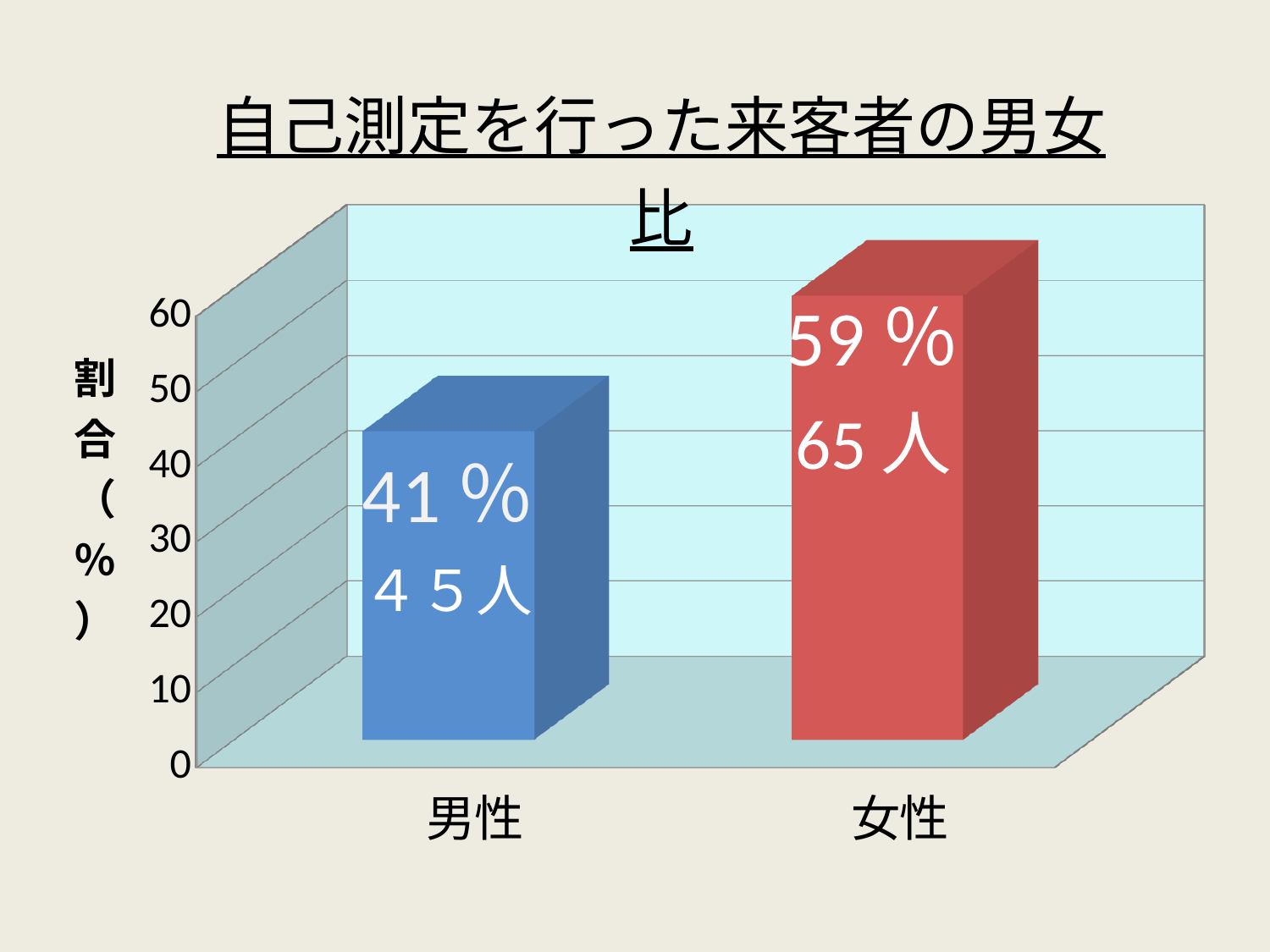
What is the title of the chart? 自己測定を行った来客者の男女比 Which category has the higher percentage? 女性 What is the difference in percentage points between 女性 and 男性? 18 How many people does the 女性 bar label show? 65人 How many people does the 男性 bar label show? ４５人 Which category has the lower percentage? 男性 Is the value for 男性 greater or less than 50? less What percentage is shown for 男性? 41％ How many more people are in the 女性 group than the 男性 group? 20人 What percentage is shown for 女性? 59％ What kind of chart is shown on the slide? bar chart How many categories are shown on the x axis? 2